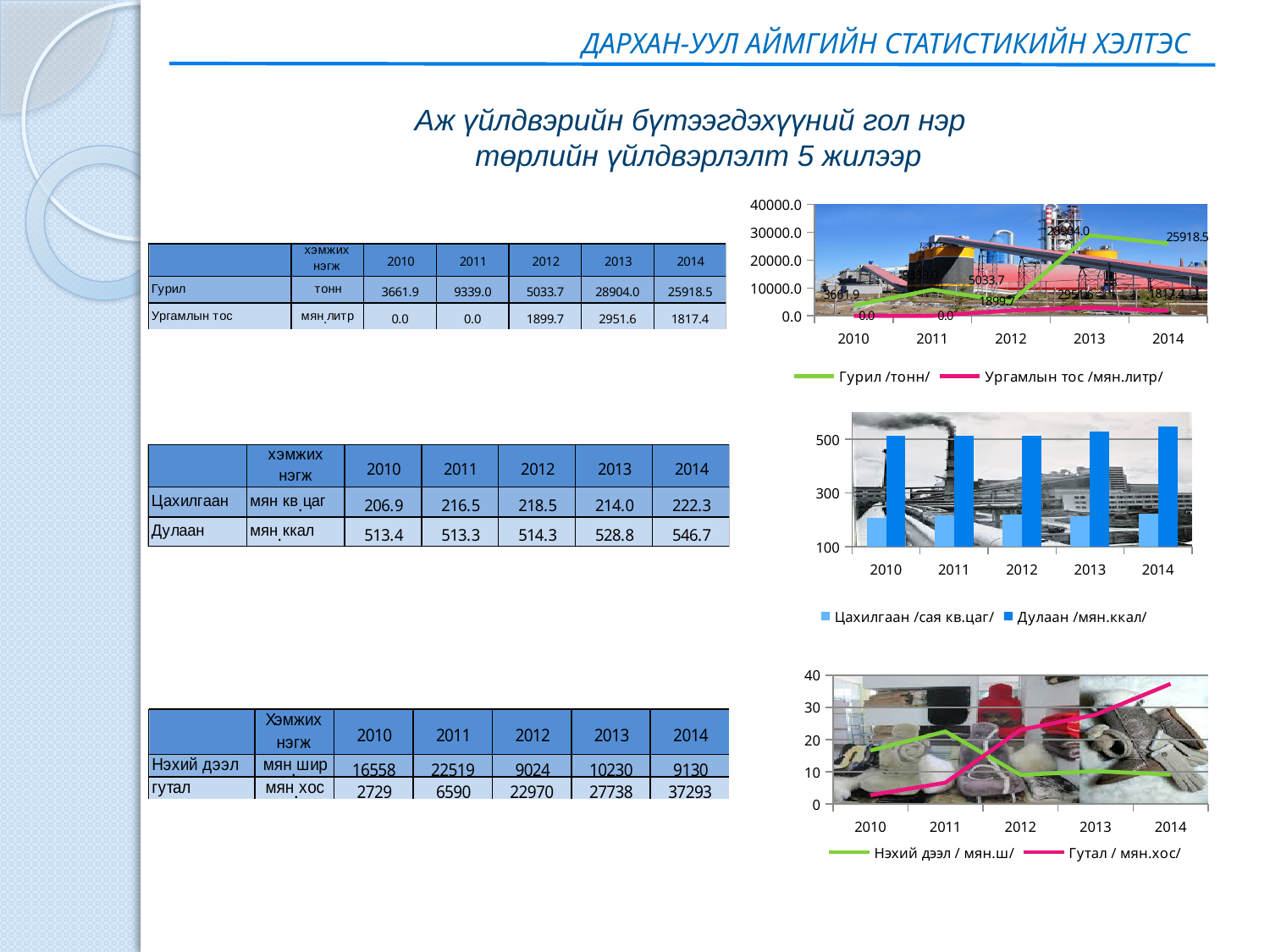
In the top-right line chart, how many series does the legend list? 2 In the middle-right bar chart, is the value for Цахилгаан /сая кв.цаг/ in 2010 greater or less than 300? less In the top-right line chart, what is the value for Гурил /тонн/ in 2013? 28904.0 In the top-right line chart, how many years are plotted on the x axis? 5 In the middle-right bar chart, is the value for Дулаан /мян.ккал/ in 2014 greater or less than 500? greater What kind of chart is the top-right chart with the legend 'Гурил /тонн/' and 'Ургамлын тос /мян.литр/'? line chart In the top-right line chart, what is the difference between the Гурил /тонн/ values for 2013 and 2014? 2985.5 What kind of chart is the middle-right chart with the legend 'Цахилгаан /сая кв.цаг/' and 'Дулаан /мян.ккал/'? bar chart In the top-right line chart, what is the value for Ургамлын тос /мян.литр/ in 2012? 1899.7 In the top-right line chart, in which year is Гурил /тонн/ highest? 2013 In the bottom-right line chart, which series has the larger value in 2014, Нэхий дээл / мян.ш/ or Гутал / мян.хос/? Гутал / мян.хос/ In the bottom-right line chart, does the Гутал / мян.хос/ line rise or fall from 2010 to 2014? rise